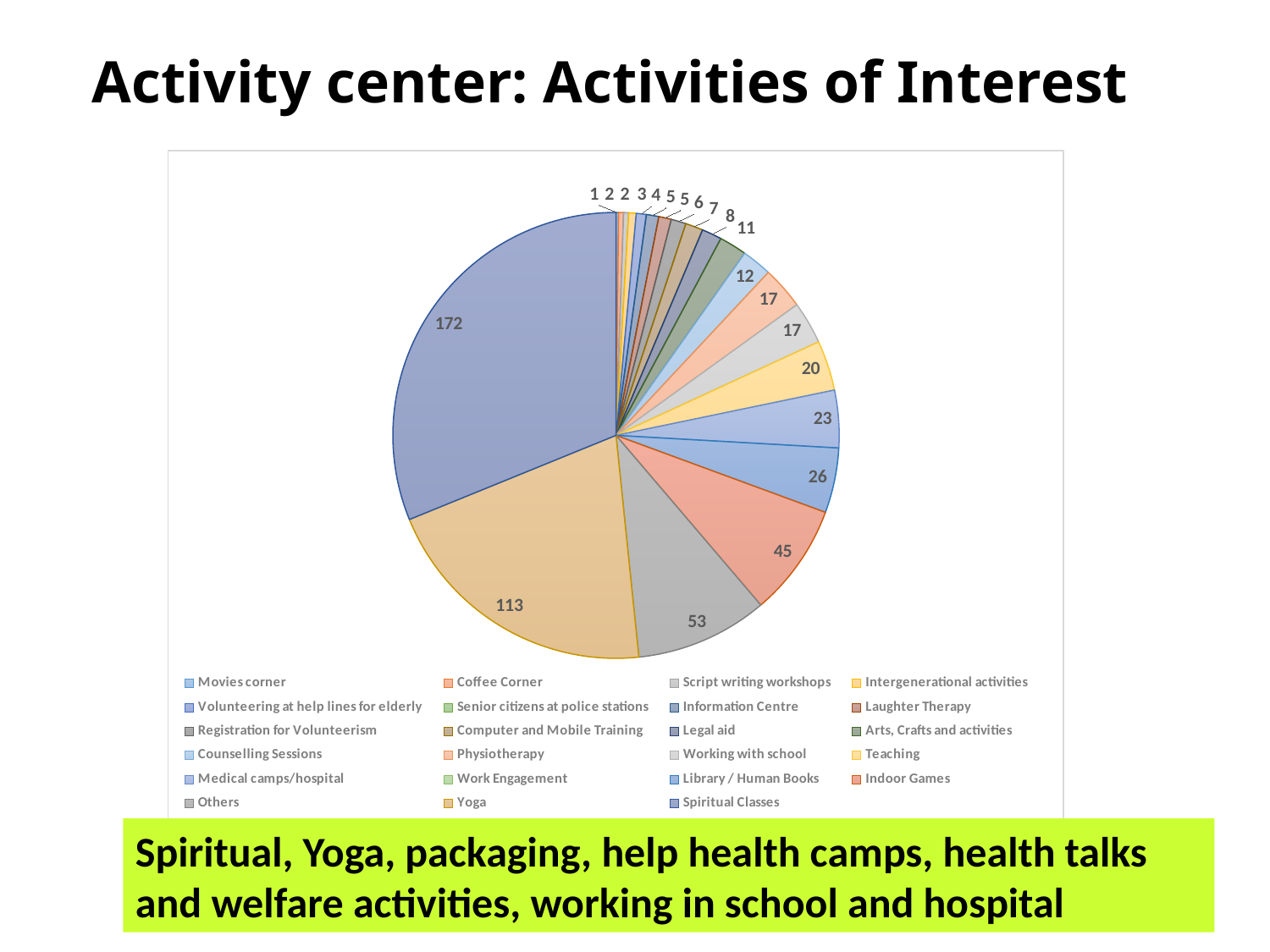
What kind of chart is shown on the slide? pie chart What is the value of the slice for Spiritual Classes, the large blue slice? 172 Which is larger, the slice labelled 53 or the slice labelled 45? 53 What is the difference between the slices labelled 53 and 45? 8 What is the title of the slide containing the pie chart? Activity center: Activities of Interest Which legend entry is listed last in the pie chart's legend? Spiritual Classes What is the second-largest value labelled on the pie chart? 113 How many slices on the pie chart are labelled 17? 2 What is the smallest value labelled on the pie chart? 1 What is the largest value labelled on the pie chart? 172 What is the difference between the two largest slice values, 172 and 113? 59 How many categories does the legend of the pie chart list? 23